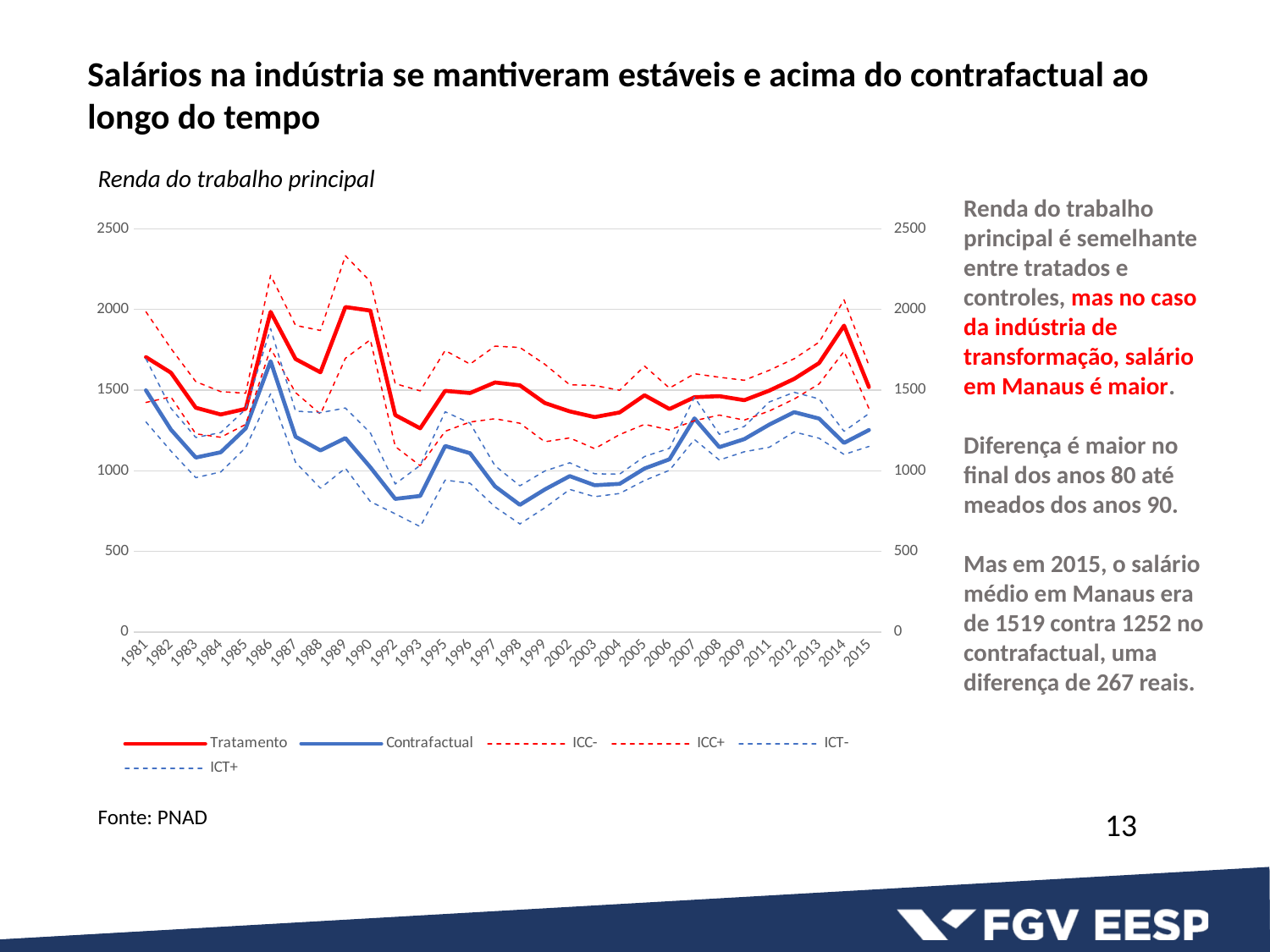
According to the slide, what was the Contrafactual value in 2015? 1252 Is the Tratamento value for 1986 greater or less than 1500? greater In which year does the Contrafactual line reach its highest value? 1986 What is the difference between the Tratamento and Contrafactual values in 2015, as stated on the slide? 267 reais What is the title of the chart? Renda do trabalho principal Is the Contrafactual value for 1992 greater or less than 1000? less What kind of chart is shown on the slide? Line chart In 1990, which is larger, the Tratamento value or the Contrafactual value? Tratamento How many series does the chart legend list? 6 According to the slide, what was the Tratamento (Manaus) average salary in 2015? 1519 What colour is the Tratamento line in the chart? Red How many years are labelled along the x axis of the chart? 30